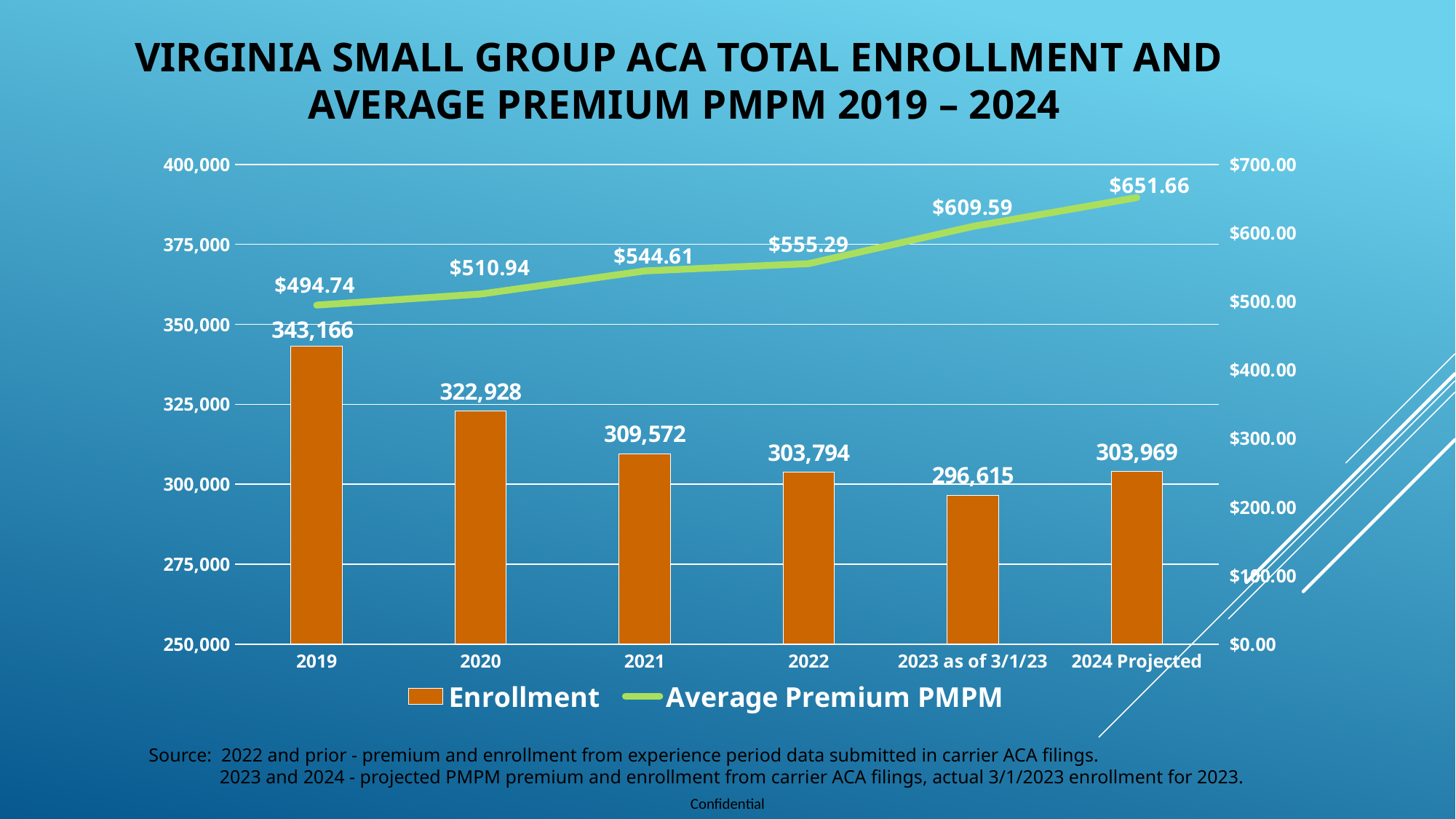
What is the projected Average Premium PMPM for 2024? $651.66 What was the Enrollment in 2019? 343,166 Which year has the highest Enrollment? 2019 Which year has the lowest Average Premium PMPM? 2019 Does the Average Premium PMPM rise or fall from 2019 to 2024? rise What is the Enrollment for 2023 as of 3/1/23? 296,615 Which is larger, the Enrollment in 2020 or in 2021? 2020 What was the Average Premium PMPM in 2021? $544.61 By how much does the Average Premium PMPM increase from 2019 to 2024 Projected? $156.92 How many series does the legend list? 2 How many years are shown on the x axis? 6 What is the difference in Enrollment between 2019 and 2023 as of 3/1/23? 46,551